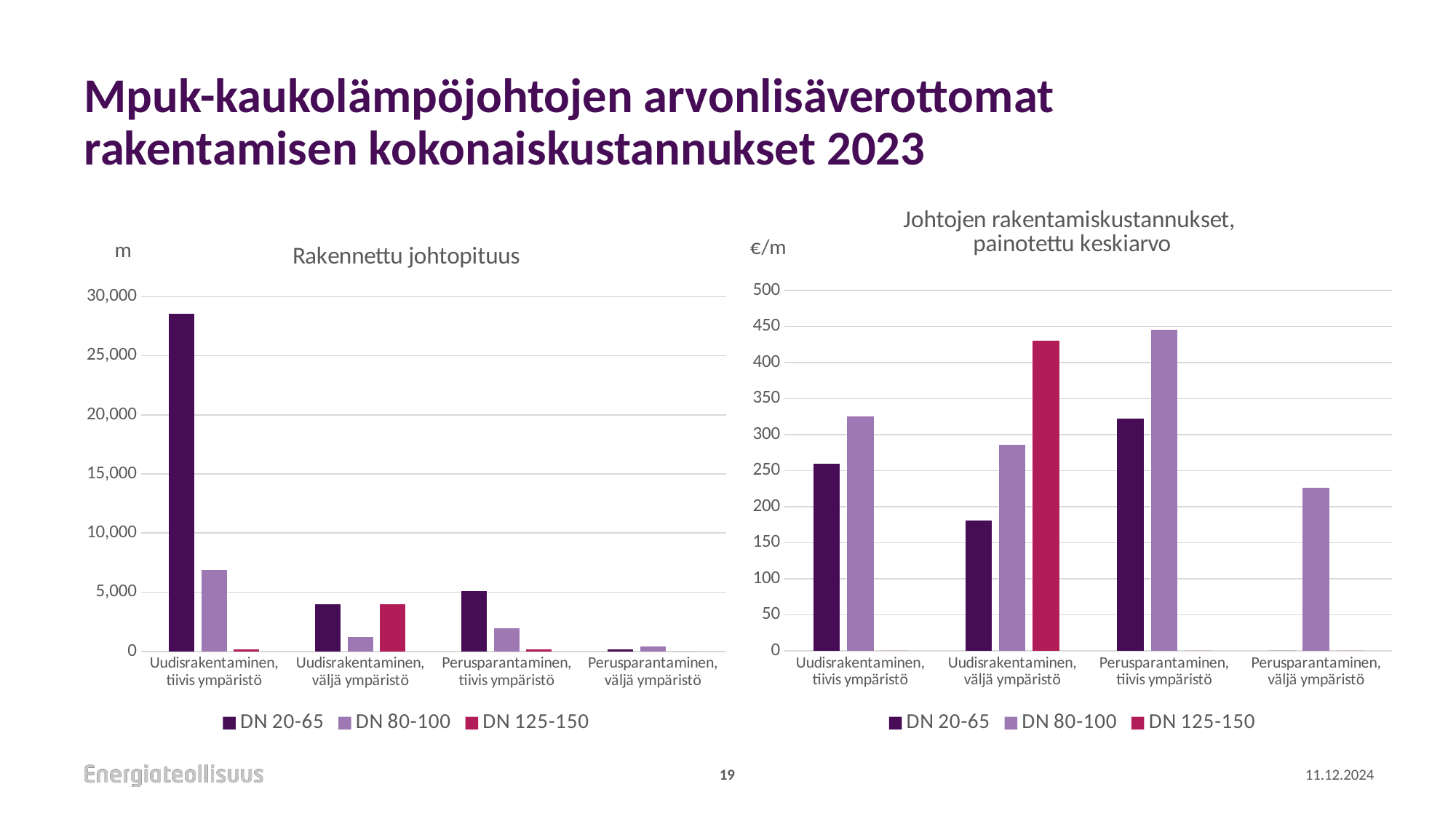
In the right chart "Johtojen rakentamiskustannukset, painotettu keskiarvo", is the DN 20-65 value for Uudisrakentaminen, väljä ympäristö greater or less than 200? less In the left chart "Rakennettu johtopituus", which category has the highest DN 20-65 bar? Uudisrakentaminen, tiivis ympäristö What type of chart is the left chart titled "Rakennettu johtopituus"? bar chart In the left chart "Rakennettu johtopituus", is the DN 20-65 value for Uudisrakentaminen, tiivis ympäristö greater or less than 25,000? greater In the right chart "Johtojen rakentamiskustannukset, painotettu keskiarvo", is the DN 80-100 value for Uudisrakentaminen, tiivis ympäristö greater or less than 300? greater How many categories are shown on the x axis of the left chart "Rakennettu johtopituus"? 4 In the left chart "Rakennettu johtopituus", which is larger for Perusparantaminen, tiivis ympäristö: DN 20-65 or DN 80-100? DN 20-65 In the right chart "Johtojen rakentamiskustannukset, painotettu keskiarvo", which is larger for Perusparantaminen, tiivis ympäristö: DN 20-65 or DN 80-100? DN 80-100 How many series does the legend of the right chart "Johtojen rakentamiskustannukset, painotettu keskiarvo" list? 3 What unit is shown on the y axis of the right chart "Johtojen rakentamiskustannukset, painotettu keskiarvo"? €/m